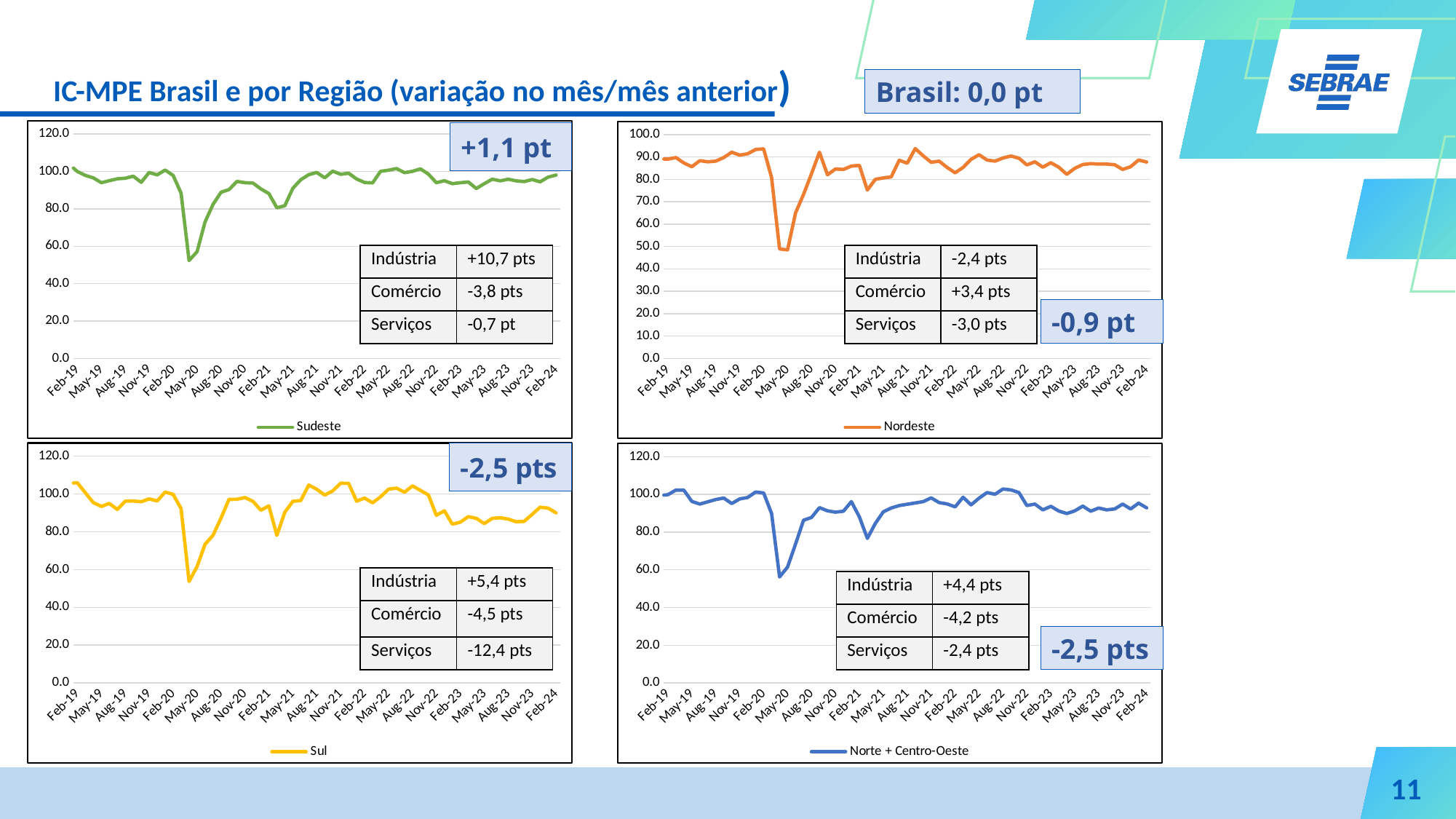
How many series does the legend of the top-right chart (Nordeste) list? 1 In the top-right chart (Nordeste), is the value at May-20 greater or less than 60? less In the top-left chart (Sudeste), is the value at May-20 greater or less than 60? less In the top-right chart (Nordeste), is the value at Feb-24 greater or less than 80? greater In the top-left chart (Sudeste), does the line rise or fall between Feb-21 and May-21? rise What is the legend entry of the bottom-left chart? Sul What is the legend entry of the bottom-right chart? Norte + Centro-Oeste What kind of chart is the top-left chart with the Sudeste legend? line chart In the bottom-left chart (Sul), does the line rise or fall between Nov-22 and Feb-23? fall